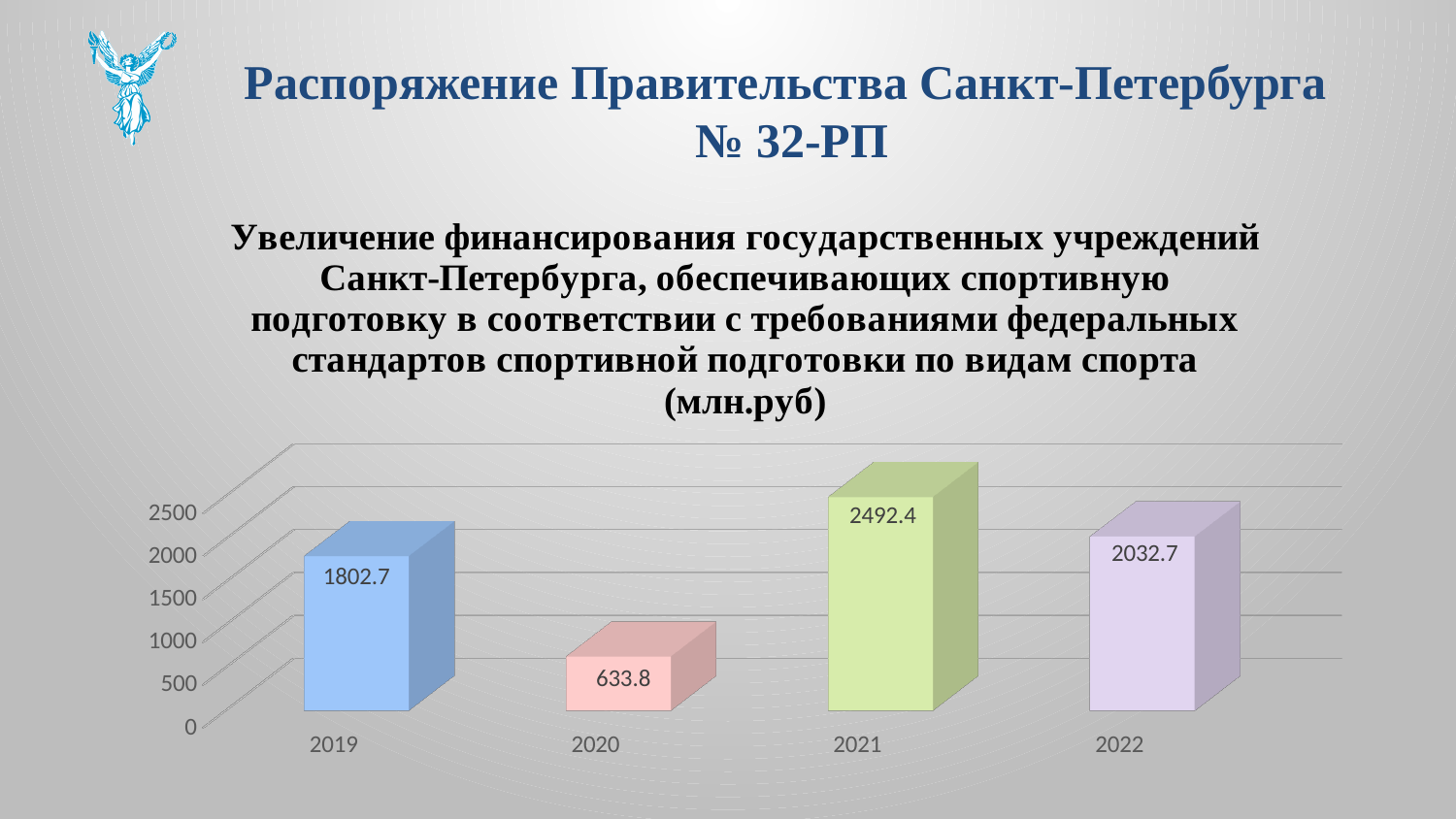
Which year has the lowest value? 2020 What is the difference between the values for 2019 and 2020? 1168.9 What is the value for 2022? 2032.7 What kind of chart is shown on the slide? bar chart Is the value for 2020 greater or less than 1000? less How many years are shown on the x axis? 4 What is the value for 2021? 2492.4 Which year has the highest value? 2021 What is the value for 2019? 1802.7 Which is larger, the value for 2019 or the value for 2022? 2022 What is the value for 2020? 633.8 What is the difference between the values for 2021 and 2022? 459.7